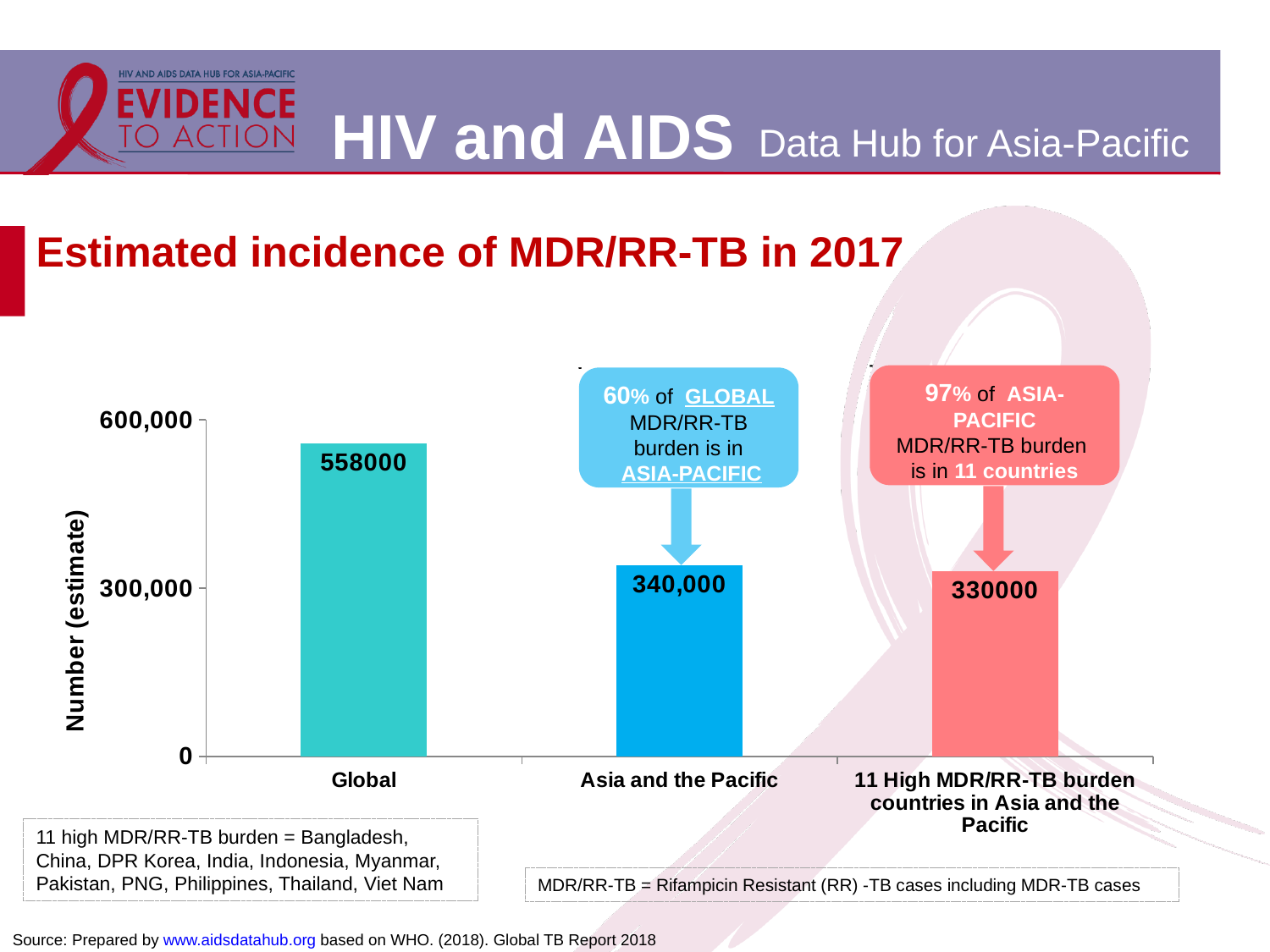
Which category has the lowest estimated incidence of MDR/RR-TB? 11 High MDR/RR-TB burden countries in Asia and the Pacific What is the estimated number of MDR/RR-TB cases for Global? 558000 What is the estimated number of MDR/RR-TB cases for the 11 High MDR/RR-TB burden countries in Asia and the Pacific? 330000 Is the value for Global greater or less than 300,000? greater Which is larger, the value for Asia and the Pacific or the value for the 11 High MDR/RR-TB burden countries in Asia and the Pacific? Asia and the Pacific What kind of chart is shown on the slide? bar chart What is the difference between the Global value and the Asia and the Pacific value? 218,000 Which category has the highest estimated incidence of MDR/RR-TB? Global How many categories are shown on the x axis of the chart? 3 What is the difference between the Asia and the Pacific value and the value for the 11 High MDR/RR-TB burden countries? 10,000 What is the estimated number of MDR/RR-TB cases for Asia and the Pacific? 340,000 What is the title of the chart's y axis? Number (estimate)